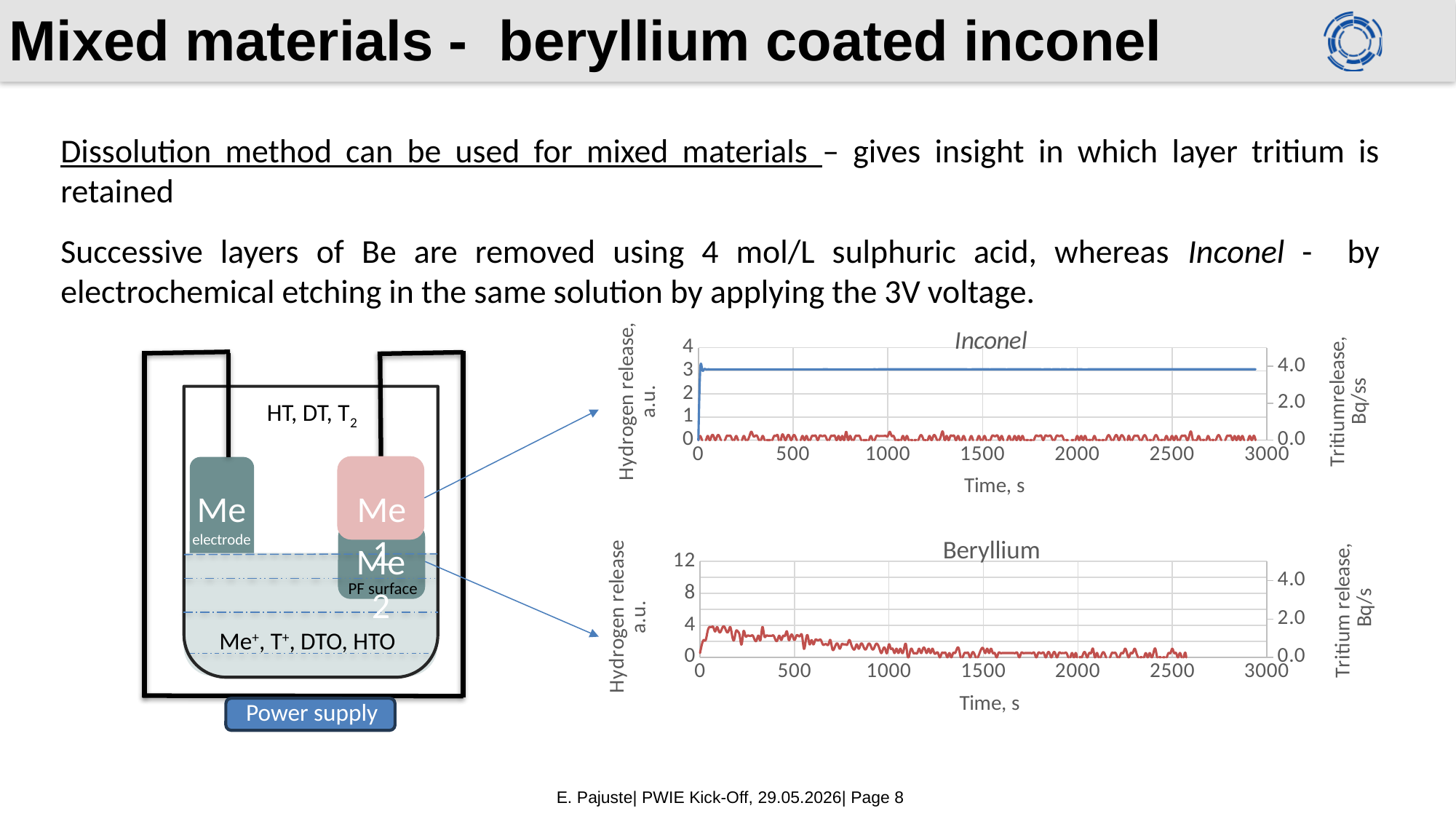
What is the maximum value shown on the x-axis of the Beryllium chart? 3000 What kind of chart is the Beryllium chart? line chart What is the x-axis label on the Inconel chart? Time, s On the Beryllium chart, does the red line rise or fall as time increases? fall On the Inconel chart, is the blue line after the initial rise greater or less than 2 on the left axis? greater On the Inconel chart, is the blue line after the initial rise greater or less than 4 on the left axis? less On the Beryllium chart, is the red line at around 2500 s greater or less than 4 on the left axis? less What is the maximum value shown on the left y-axis of the Beryllium chart? 12 What is the title of the lower chart on the slide? Beryllium What kind of chart is the Inconel chart? line chart What is the maximum value shown on the left y-axis of the Inconel chart? 4